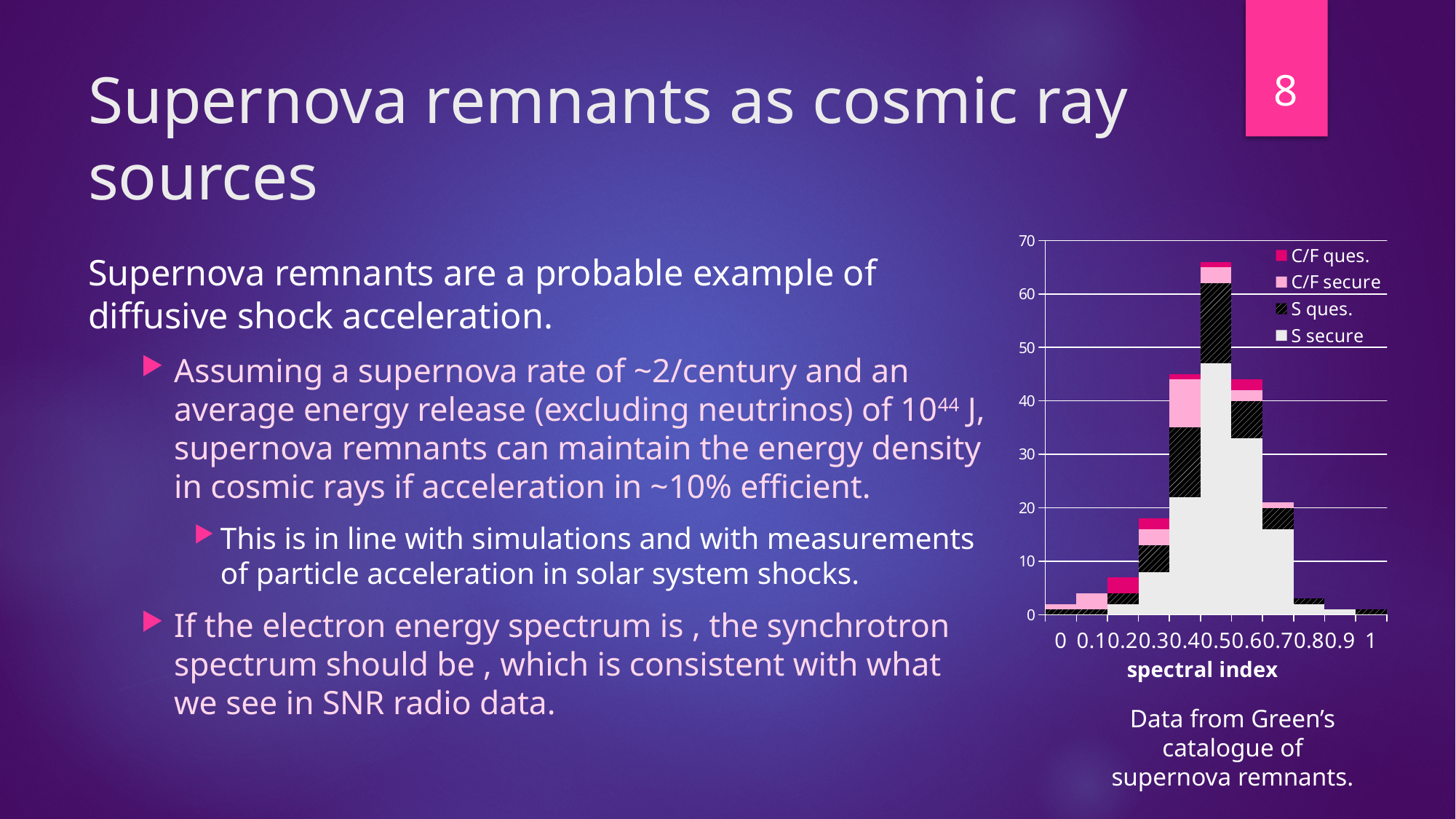
Is the total height of the bar at spectral index 0.6 greater or less than 10? greater What kind of chart is shown on the slide? stacked bar chart Is the total height of the bar at spectral index 0.4 greater or less than 60? less Is the total height of the bar at spectral index 0.5 greater or less than 50? greater How many series does the chart legend list? 4 What is the title of the x axis of the chart? spectral index Which stacked bar is taller, the one at spectral index 0.2 or the one at 0.7? 0.7 How many spectral index categories are shown along the x axis of the chart? 11 Which stacked bar is taller, the one at spectral index 0.4 or the one at 0.5? 0.5 Which spectral index category has the tallest stacked bar? 0.5 Which legend entry is shown with a black hatched pattern? S ques.